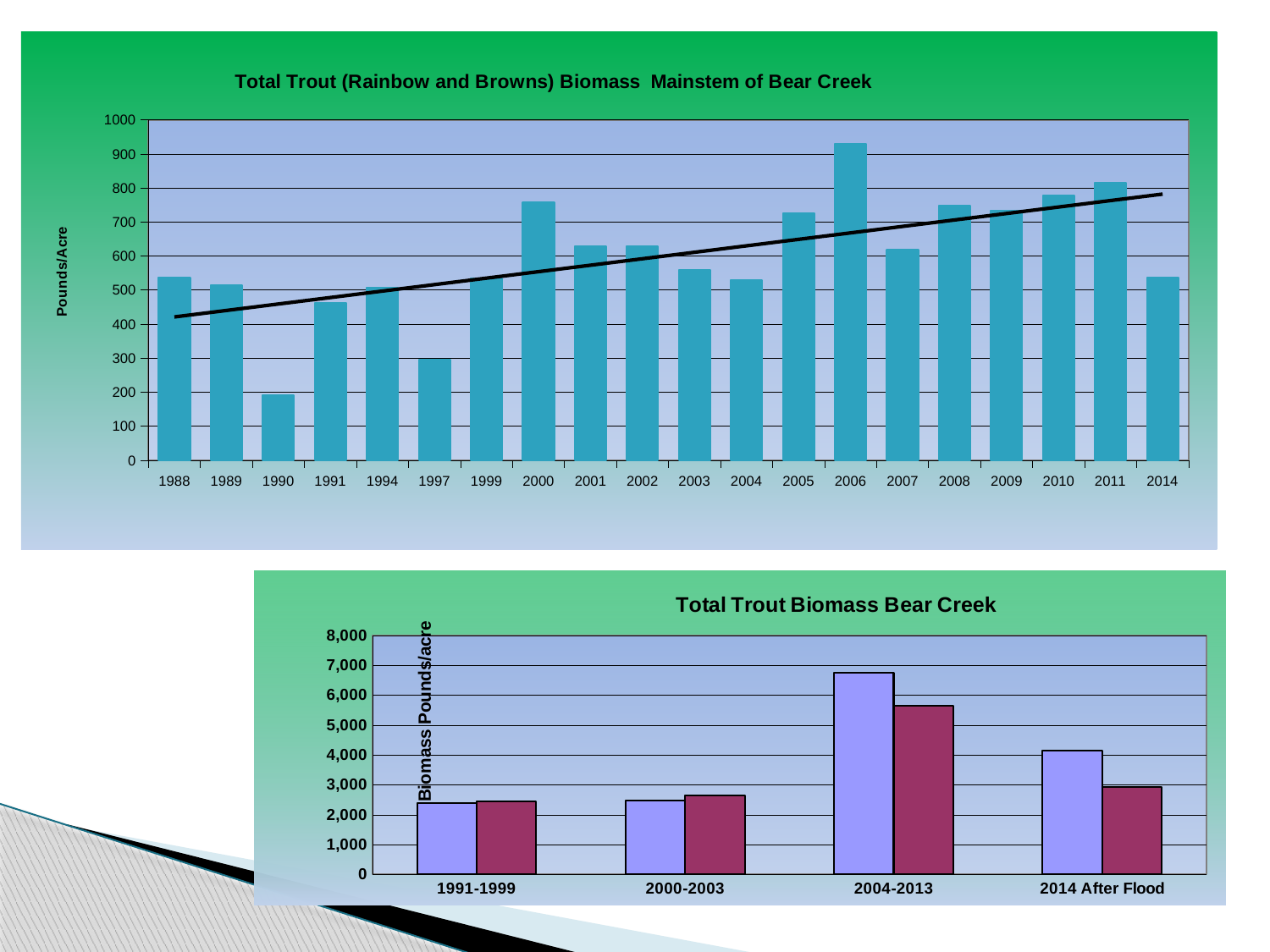
In the bottom chart, 'Total Trout Biomass Bear Creek', how many period categories are shown on the x axis? 4 In the bottom chart, 'Total Trout Biomass Bear Creek', which period has the highest biomass? 2004-2013 In the top chart, 'Total Trout (Rainbow and Browns) Biomass Mainstem of Bear Creek', which year has the lowest biomass? 1990 What is the y-axis label of the top chart, 'Total Trout (Rainbow and Browns) Biomass Mainstem of Bear Creek'? Pounds/Acre In the top chart, 'Total Trout (Rainbow and Browns) Biomass Mainstem of Bear Creek', how many years are shown on the x axis? 20 In the top chart, 'Total Trout (Rainbow and Browns) Biomass Mainstem of Bear Creek', is the value for 2006 greater or less than 900? greater What kind of chart is the top chart, 'Total Trout (Rainbow and Browns) Biomass Mainstem of Bear Creek'? Bar chart In the top chart, 'Total Trout (Rainbow and Browns) Biomass Mainstem of Bear Creek', which year has the highest biomass? 2006 In the top chart, 'Total Trout (Rainbow and Browns) Biomass Mainstem of Bear Creek', is the value for 2000 greater or less than 700? greater In the top chart, 'Total Trout (Rainbow and Browns) Biomass Mainstem of Bear Creek', does the trend line rise or fall from 1988 to 2014? Rises In the bottom chart, 'Total Trout Biomass Bear Creek', is the value of the left (blue) bar for 2004-2013 greater or less than 6,000? greater In the top chart, 'Total Trout (Rainbow and Browns) Biomass Mainstem of Bear Creek', which year has the larger value, 2000 or 2007? 2000